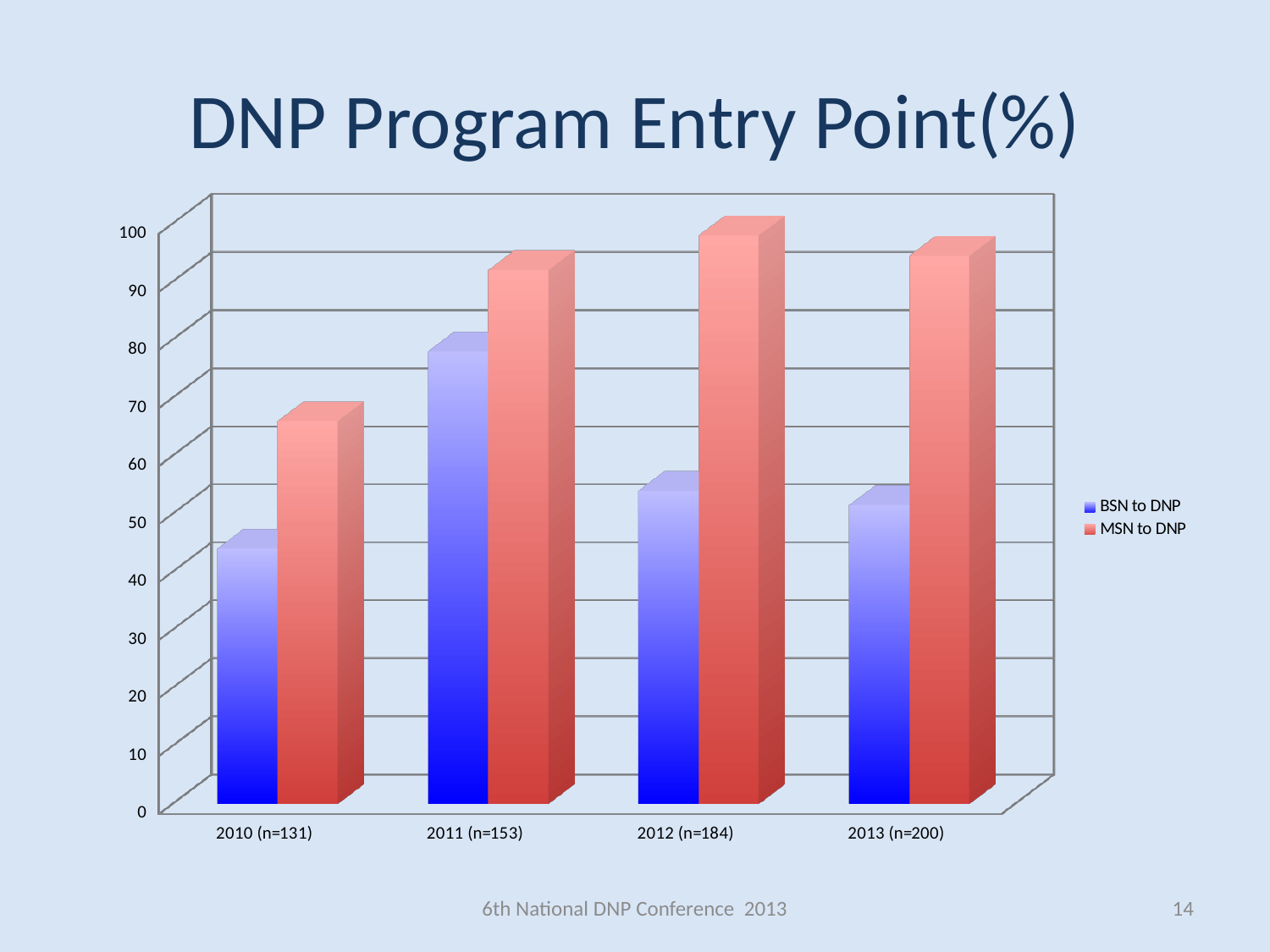
What is the title of the chart? DNP Program Entry Point(%) In which year is the MSN to DNP value highest? 2012 (n=184) How many year categories are shown on the x axis? 4 In which year is the BSN to DNP value highest? 2011 (n=153) Which series is shown in red? MSN to DNP What kind of chart is shown on the slide? bar chart Is the BSN to DNP value for 2011 (n=153) greater or less than 70? greater Is the MSN to DNP value for 2012 (n=184) greater or less than 90? greater In which year is the MSN to DNP value lowest? 2010 (n=131) How many series does the legend list? 2 In 2010 (n=131), which is larger, BSN to DNP or MSN to DNP? MSN to DNP Does the BSN to DNP value rise or fall from 2010 (n=131) to 2011 (n=153)? rise